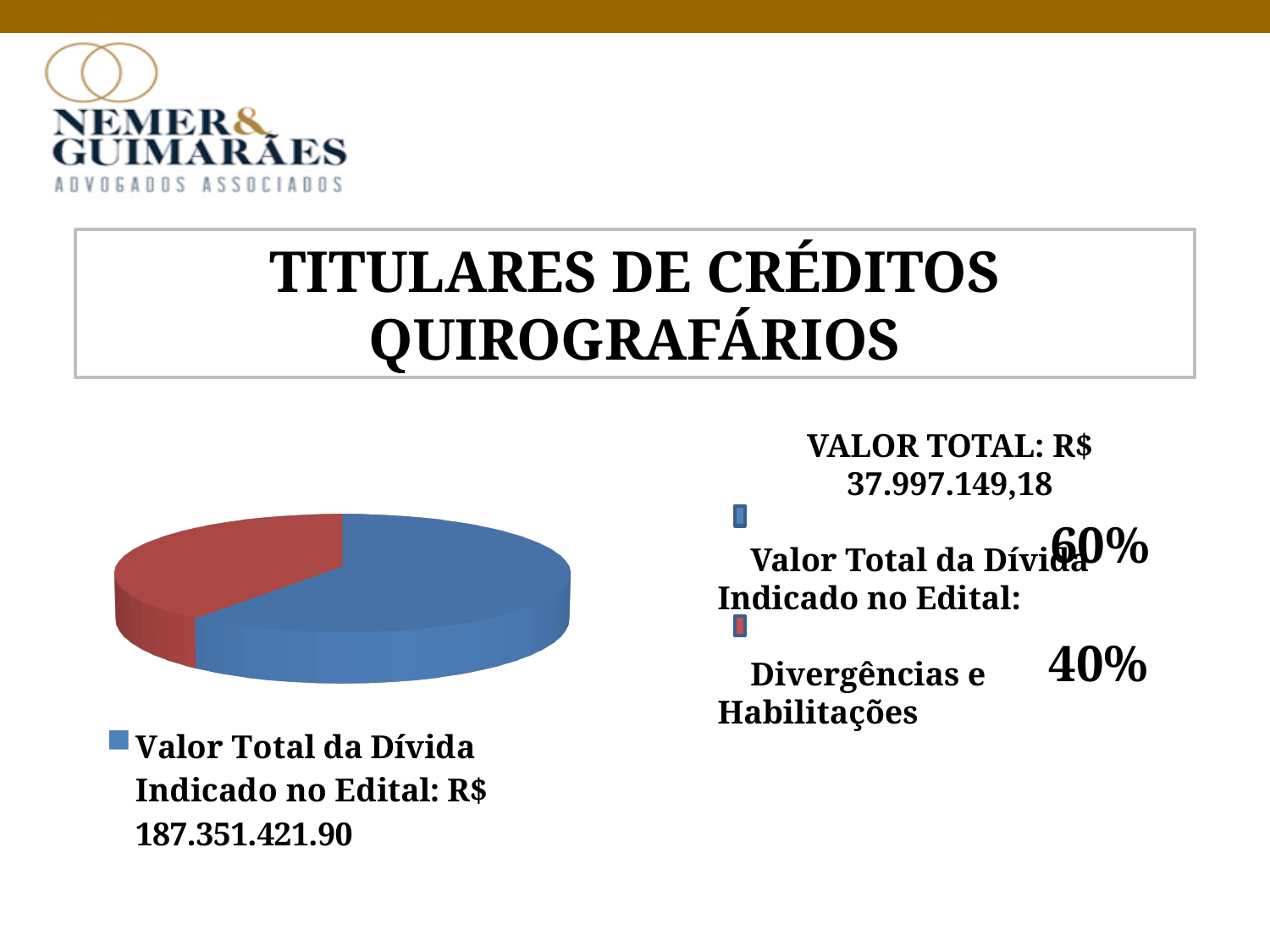
What is the total value (VALOR TOTAL) printed above the percentage labels on the right of the chart? R$ 37.997.149,18 Which is larger: the share for "Valor Total da Dívida Indicado no Edital" or the share for "Divergências e Habilitações"? Valor Total da Dívida Indicado no Edital What kind of chart is shown on the slide? pie chart What percentage is shown for "Divergências e Habilitações"? 40% How many slices does the pie chart have? 2 What colour is the slice for "Divergências e Habilitações"? red What percentage is shown for "Valor Total da Dívida Indicado no Edital"? 60% What colour is the slice for "Valor Total da Dívida Indicado no Edital"? blue What is the difference in percentage points between the two slices of the pie? 20 Which category has the smallest share of the pie? Divergências e Habilitações Which category has the largest share of the pie? Valor Total da Dívida Indicado no Edital